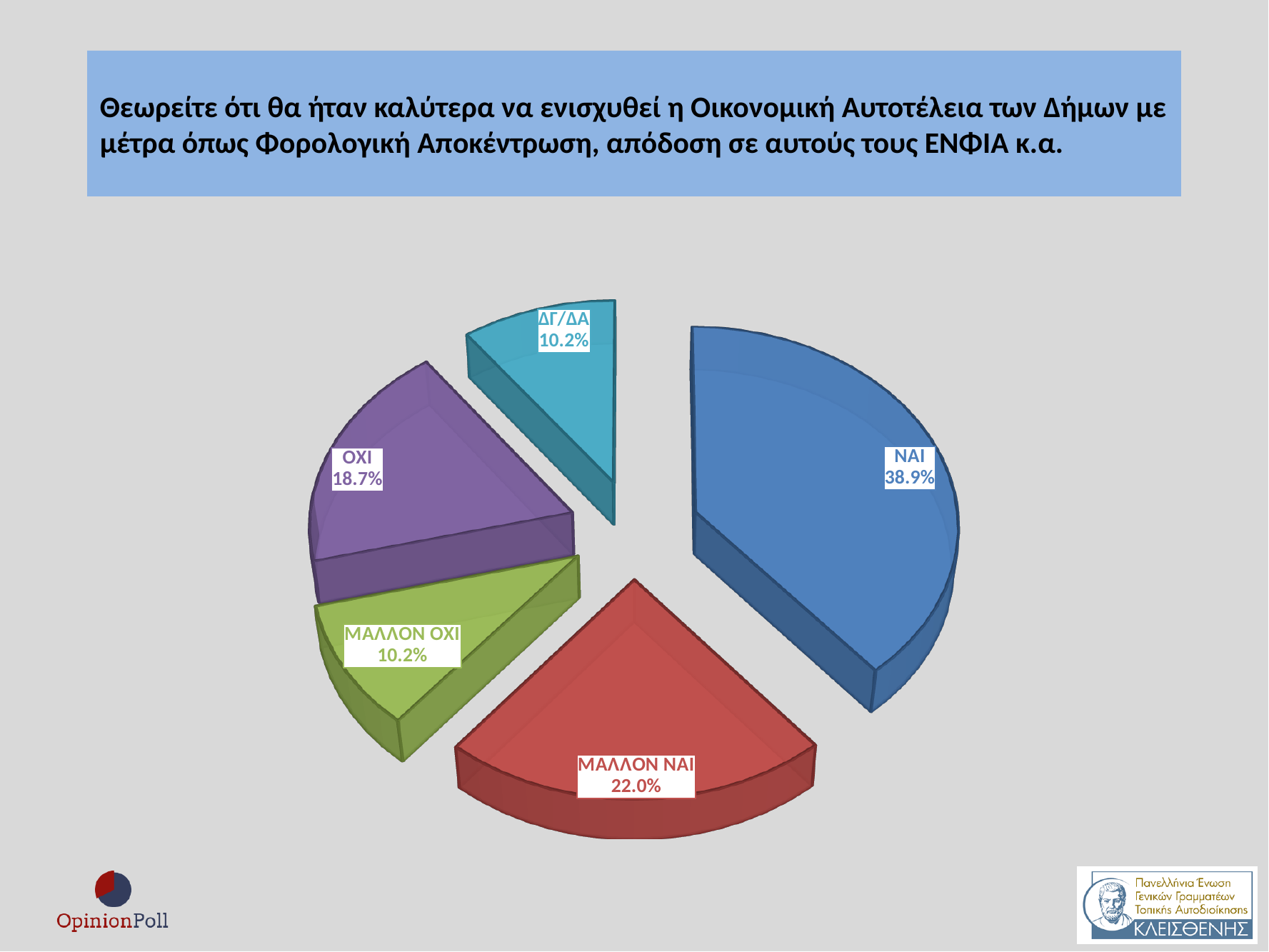
What percentage is shown for ΝΑΙ? 38.9% What kind of chart is shown on the slide? pie chart What is the difference in percentage points between ΝΑΙ and ΜΑΛΛΟΝ ΝΑΙ? 16.9 What percentage is shown for ΟΧΙ? 18.7% How many slices does the pie chart have? 5 What percentage is shown for ΔΓ/ΔΑ? 10.2% What is the combined share of ΝΑΙ and ΜΑΛΛΟΝ ΝΑΙ? 60.9% What colour is the ΝΑΙ slice? blue What percentage is shown for ΜΑΛΛΟΝ ΝΑΙ? 22.0% What is the difference in percentage points between ΟΧΙ and ΜΑΛΛΟΝ ΟΧΙ? 8.5 Which is larger, the slice for ΜΑΛΛΟΝ ΝΑΙ or the slice for ΟΧΙ? ΜΑΛΛΟΝ ΝΑΙ Which category has the largest slice of the pie? ΝΑΙ